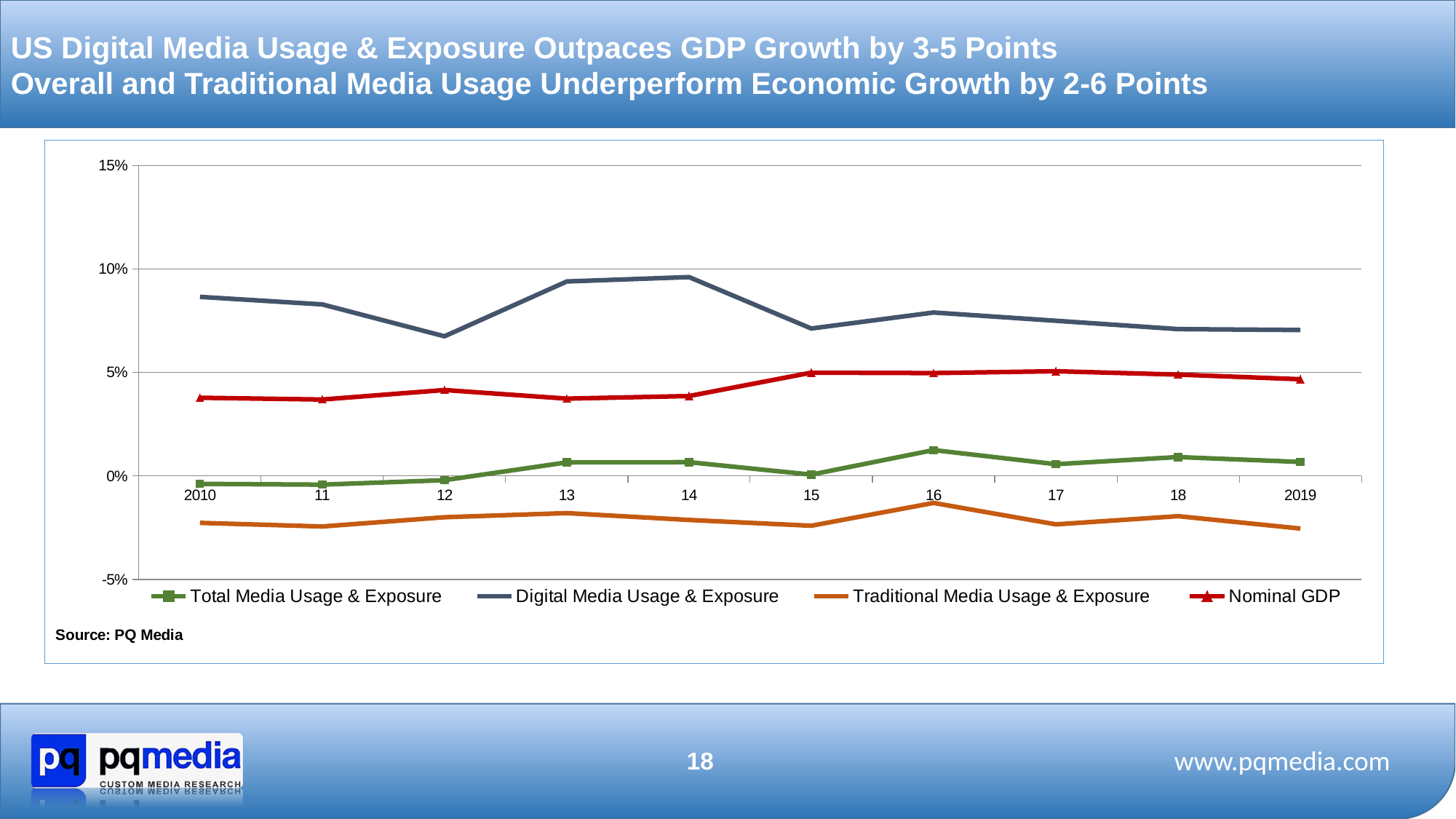
In which year does Traditional Media Usage & Exposure reach its highest value? 2016 Is the value for Digital Media Usage & Exposure in 2014 greater or less than 5%? greater How many series does the legend list? 4 Is the value for Nominal GDP in 2010 greater or less than 5%? less What source is cited below the chart? PQ Media Is the value for Traditional Media Usage & Exposure in 2019 greater or less than 0%? less In 2013, which is larger: Digital Media Usage & Exposure or Nominal GDP? Digital Media Usage & Exposure Which series has the lowest value in 2010? Traditional Media Usage & Exposure Does the Digital Media Usage & Exposure line rise or fall from 2016 to 2019? fall How many years are plotted along the x axis? 10 Which series has the highest value in 2014? Digital Media Usage & Exposure What kind of chart is shown on the slide? line chart